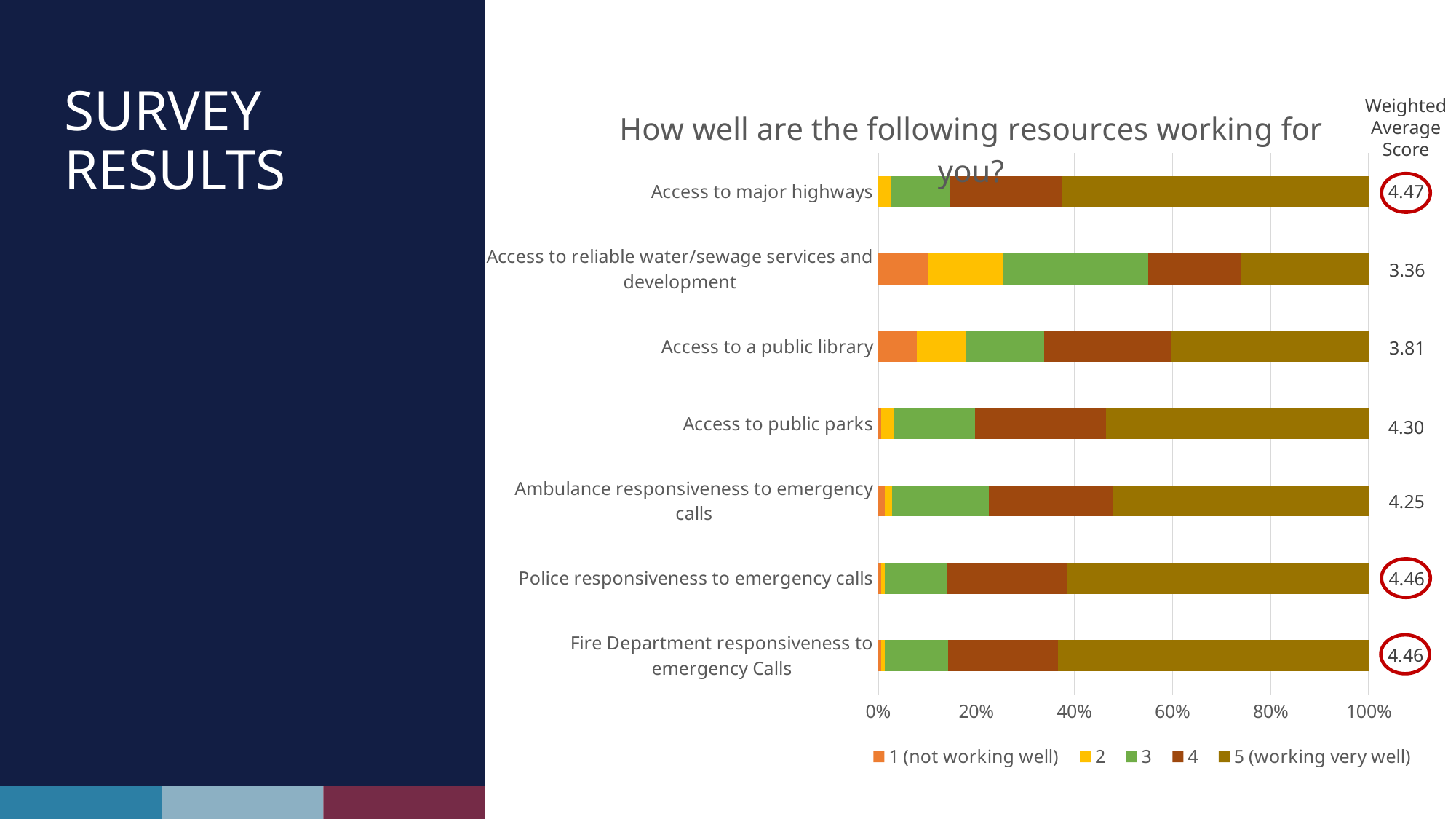
What is the difference between the Weighted Average Scores for Access to major highways and Access to reliable water/sewage services and development? 1.11 Which resource has the lowest Weighted Average Score? Access to reliable water/sewage services and development Which has the higher Weighted Average Score, Access to a public library or Access to public parks? Access to public parks What kind of chart is shown on the slide? Stacked bar chart What is the Weighted Average Score for Access to reliable water/sewage services and development? 3.36 What is the Weighted Average Score for Ambulance responsiveness to emergency calls? 4.25 What is the Weighted Average Score for Access to major highways? 4.47 How many series does the legend list? 5 What is the legend label for the first (orange) series? 1 (not working well) Which resource has the highest Weighted Average Score? Access to major highways Is the share of '5 (working very well)' responses for Access to reliable water/sewage services and development greater or less than 40%? less How many resources (categories) are listed on the chart? 7